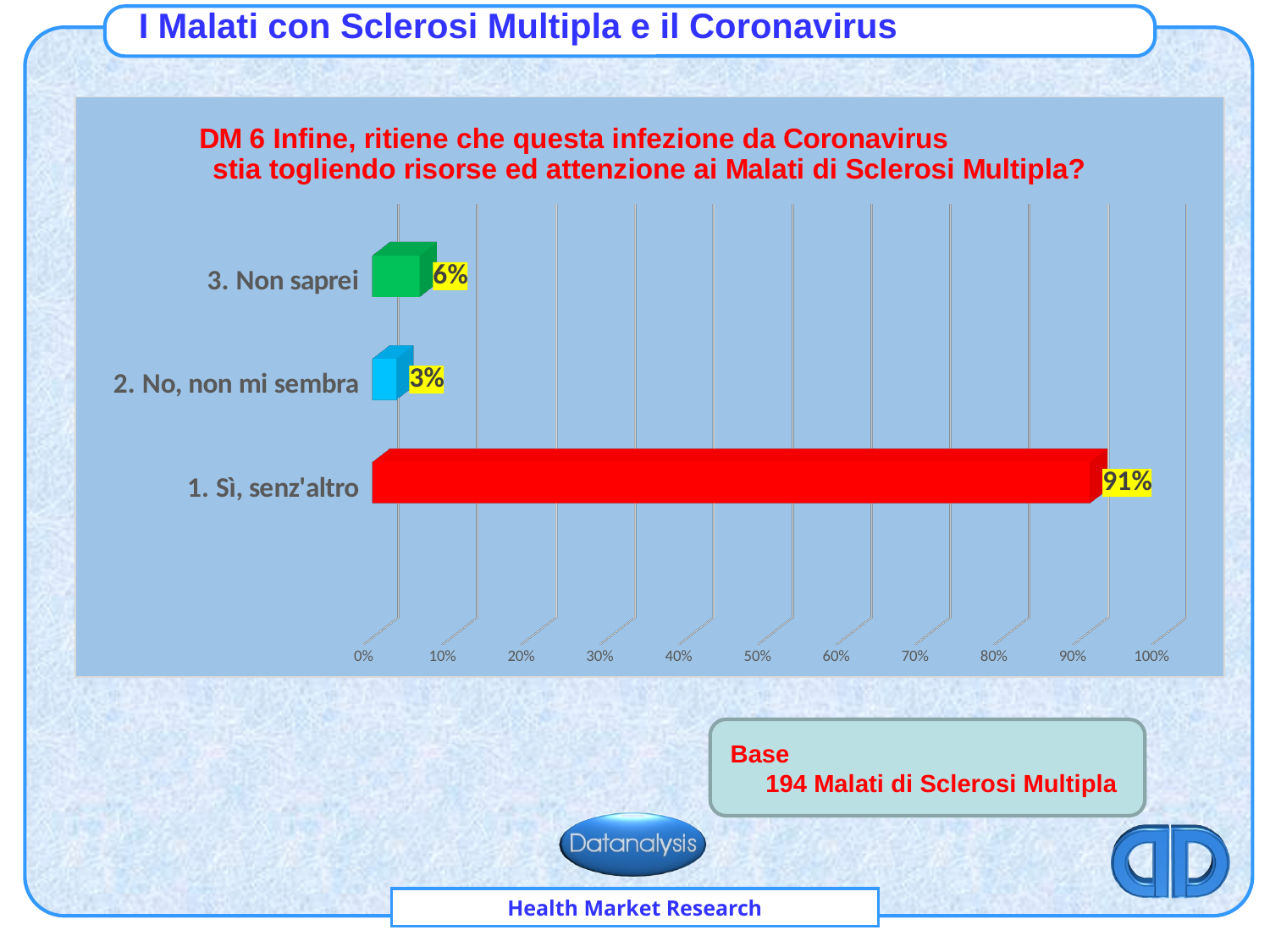
Which is larger, the value for "3. Non saprei" or the value for "2. No, non mi sembra"? 3. Non saprei Which category has the lowest value? 2. No, non mi sembra What is the difference between the values for "1. Sì, senz'altro" and "3. Non saprei"? 85% What colour is the bar for "1. Sì, senz'altro"? Red What is the difference between the values for "3. Non saprei" and "2. No, non mi sembra"? 3% Is the value for "1. Sì, senz'altro" greater or less than 80%? greater What kind of chart is shown on the slide? Bar chart What is the value for "2. No, non mi sembra"? 3% How many categories are shown in the chart? 3 Which category has the highest value? 1. Sì, senz'altro What is the value for "3. Non saprei"? 6% What is the value for "1. Sì, senz'altro"? 91%